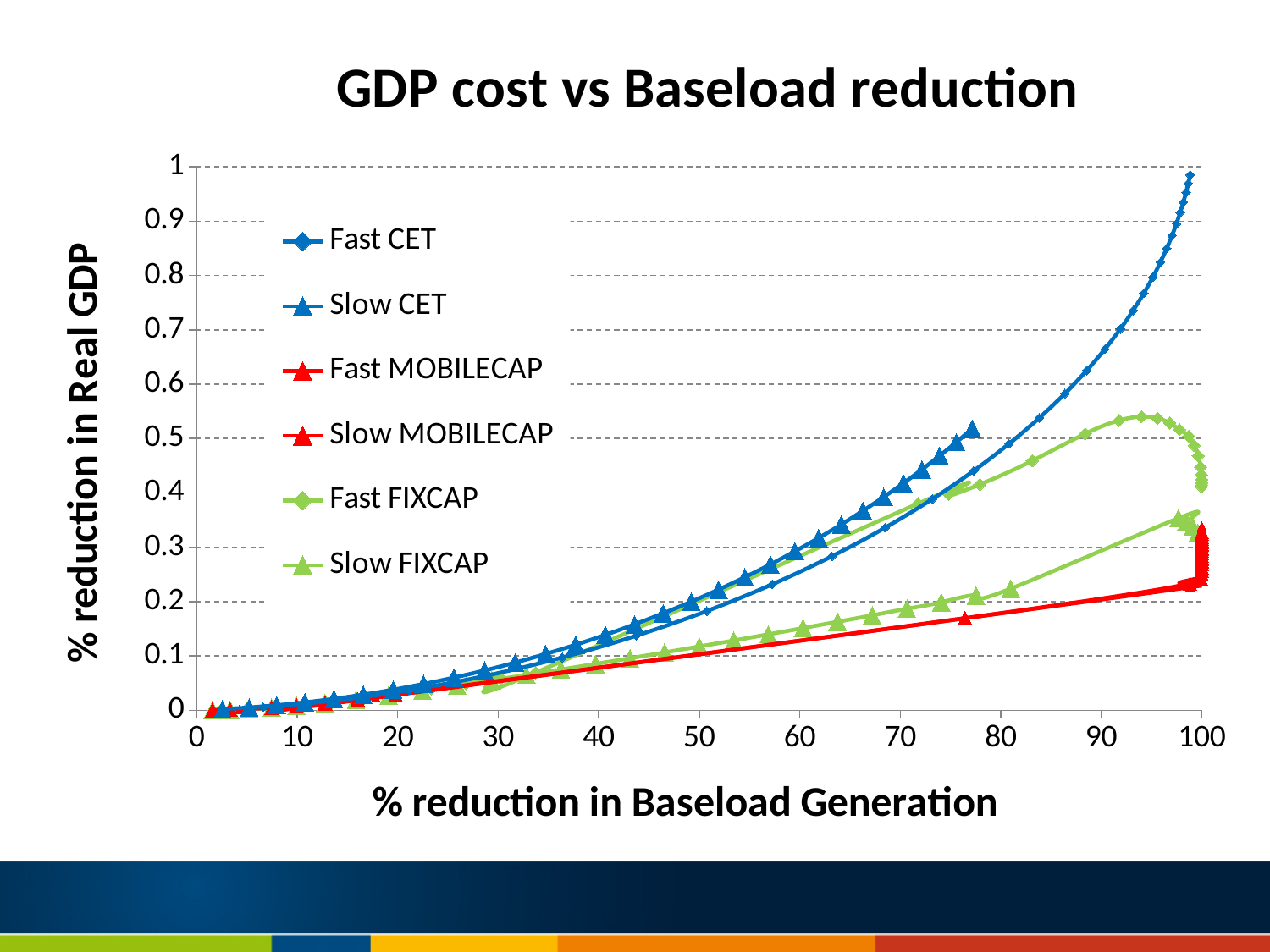
Which series reaches the highest % reduction in Real GDP? Fast CET Is the highest value reached by the Slow CET series greater or less than 0.6? less Is the peak value of the Fast FIXCAP series greater or less than 0.5? greater At 60% reduction in Baseload Generation, which series has the larger % reduction in Real GDP: Slow CET or Slow FIXCAP? Slow CET Is the highest value reached by the Fast CET series greater or less than 0.9? greater What is the label of the x axis? % reduction in Baseload Generation At 70% reduction in Baseload Generation, which series has the larger % reduction in Real GDP: Fast CET or Fast MOBILECAP? Fast CET Does the Fast CET series rise or fall as the % reduction in Baseload Generation increases? rise How many series does the legend list? 6 What is the title of the chart? GDP cost vs Baseload reduction What kind of chart is shown on the slide? line chart